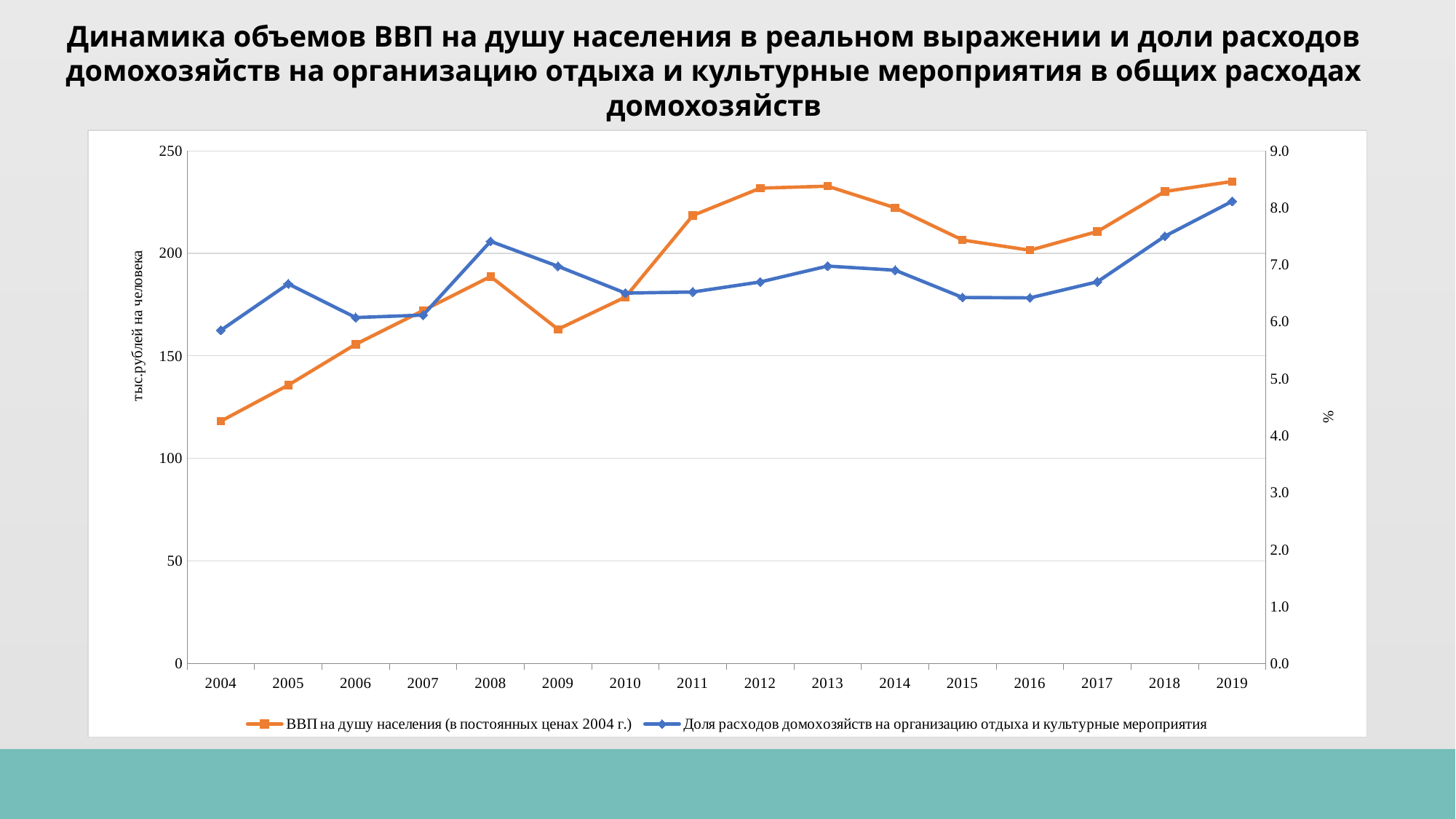
Which year has the larger value of ВВП на душу населения, 2009 or 2011? 2011 In which year is ВВП на душу населения the lowest? 2004 What kind of chart is shown on the slide? line chart How many series does the legend list? 2 In which year is Доля расходов домохозяйств на организацию отдыха и культурные мероприятия the highest? 2019 What is the label of the left vertical axis? тыс.рублей на человека Is the value of ВВП на душу населения in 2012 greater or less than 200? greater How many years are plotted along the x axis? 16 Is the value of Доля расходов домохозяйств на организацию отдыха и культурные мероприятия in 2004 greater or less than 6.0? less Is the value of ВВП на душу населения in 2004 greater or less than 150? less Which year is the first on the x axis? 2004